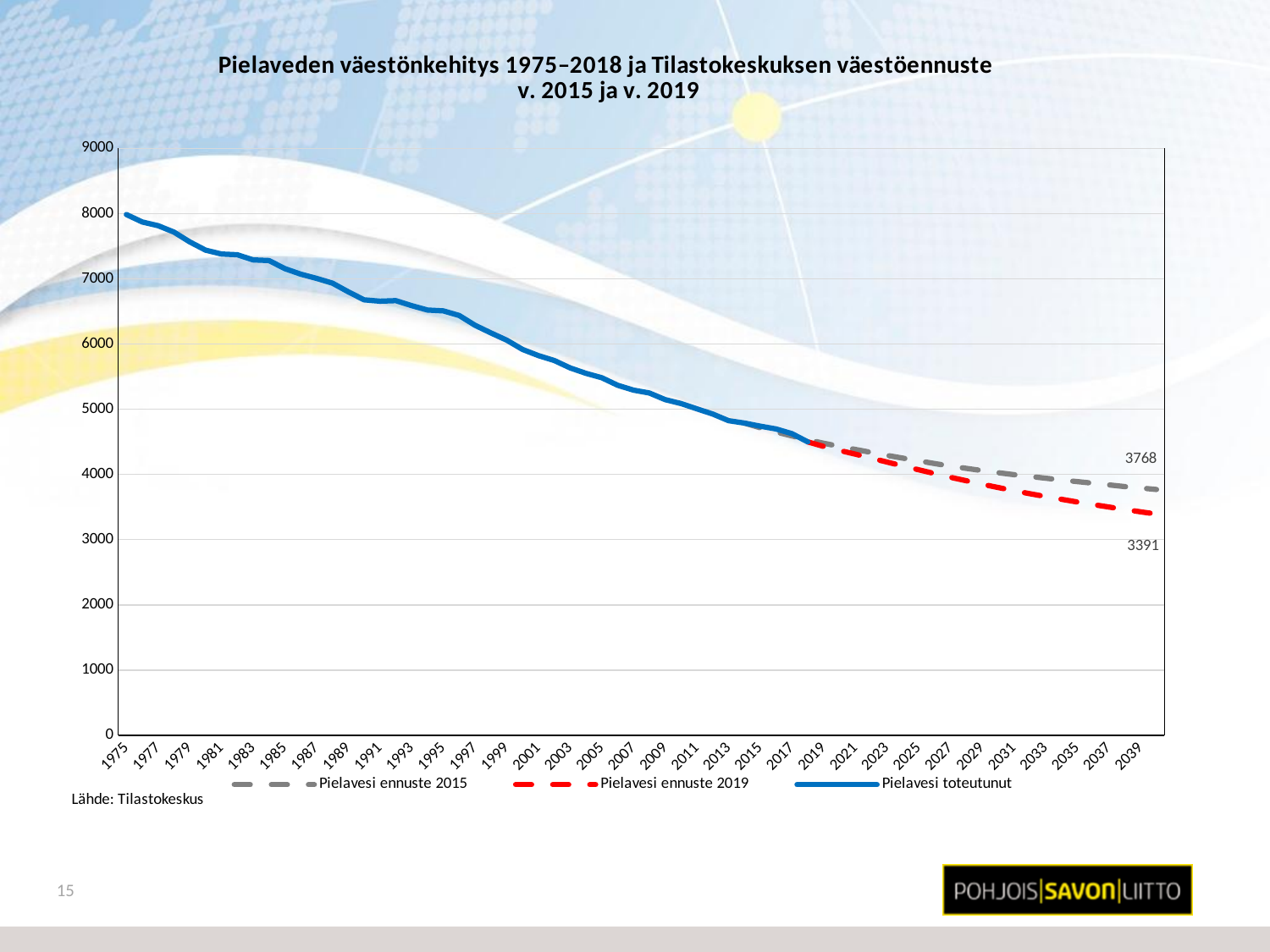
What is the title of the chart? Pielaveden väestönkehitys 1975–2018 ja Tilastokeskuksen väestöennuste v. 2015 ja v. 2019 Does the Pielavesi toteutunut series rise or fall from 1975 onwards? fall What kind of chart is shown on the slide? line chart In which year is the Pielavesi toteutunut series at its highest? 1975 What is the labelled end value of the Pielavesi ennuste 2015 series? 3768 How many series does the legend list? 3 Is the value of Pielavesi toteutunut in 1975 greater or less than 7000? greater What is the difference between the labelled end values of the Pielavesi ennuste 2015 and Pielavesi ennuste 2019 series? 377 Is the value of Pielavesi toteutunut in 2017 greater or less than 5000? less What is the labelled end value of the Pielavesi ennuste 2019 series? 3391 Which forecast series ends at a higher value, Pielavesi ennuste 2015 or Pielavesi ennuste 2019? Pielavesi ennuste 2015 What colour is the Pielavesi toteutunut line? blue